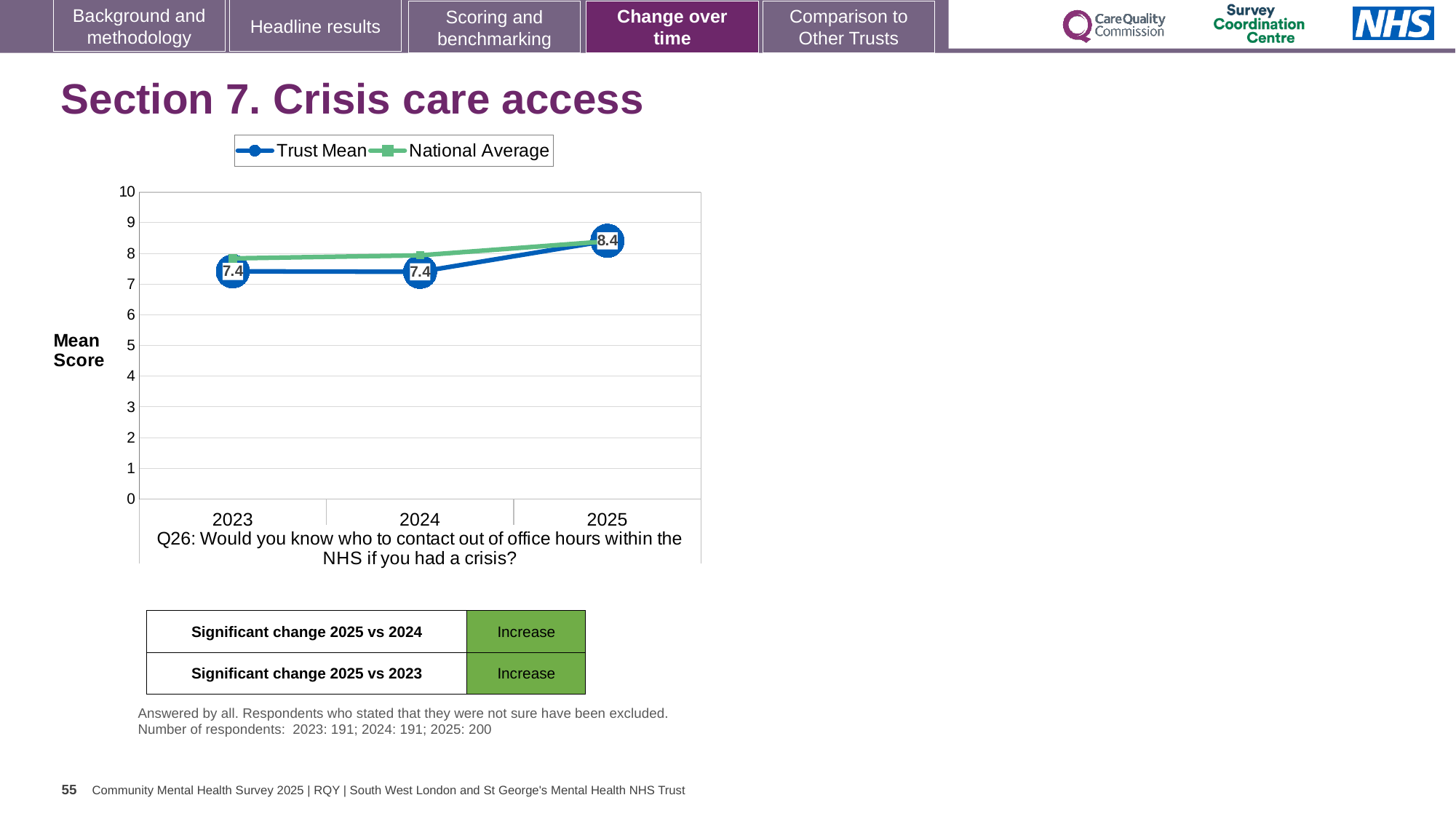
Is the National Average value for 2023 greater or less than 7? greater Is the Trust Mean score larger in 2025 or in 2024? 2025 What is the Trust Mean score for 2025? 8.4 What kind of chart is shown on the slide? Line chart What is the Trust Mean score for 2023? 7.4 In which year is the Trust Mean score highest? 2025 How many years are plotted on the x axis? 3 Is the National Average value for 2025 greater or less than 9? less What is the Trust Mean score for 2024? 7.4 How many series does the legend list? 2 Does the Trust Mean score rise or fall from 2024 to 2025? Rise What is the difference between the Trust Mean score in 2025 and in 2023? 1.0